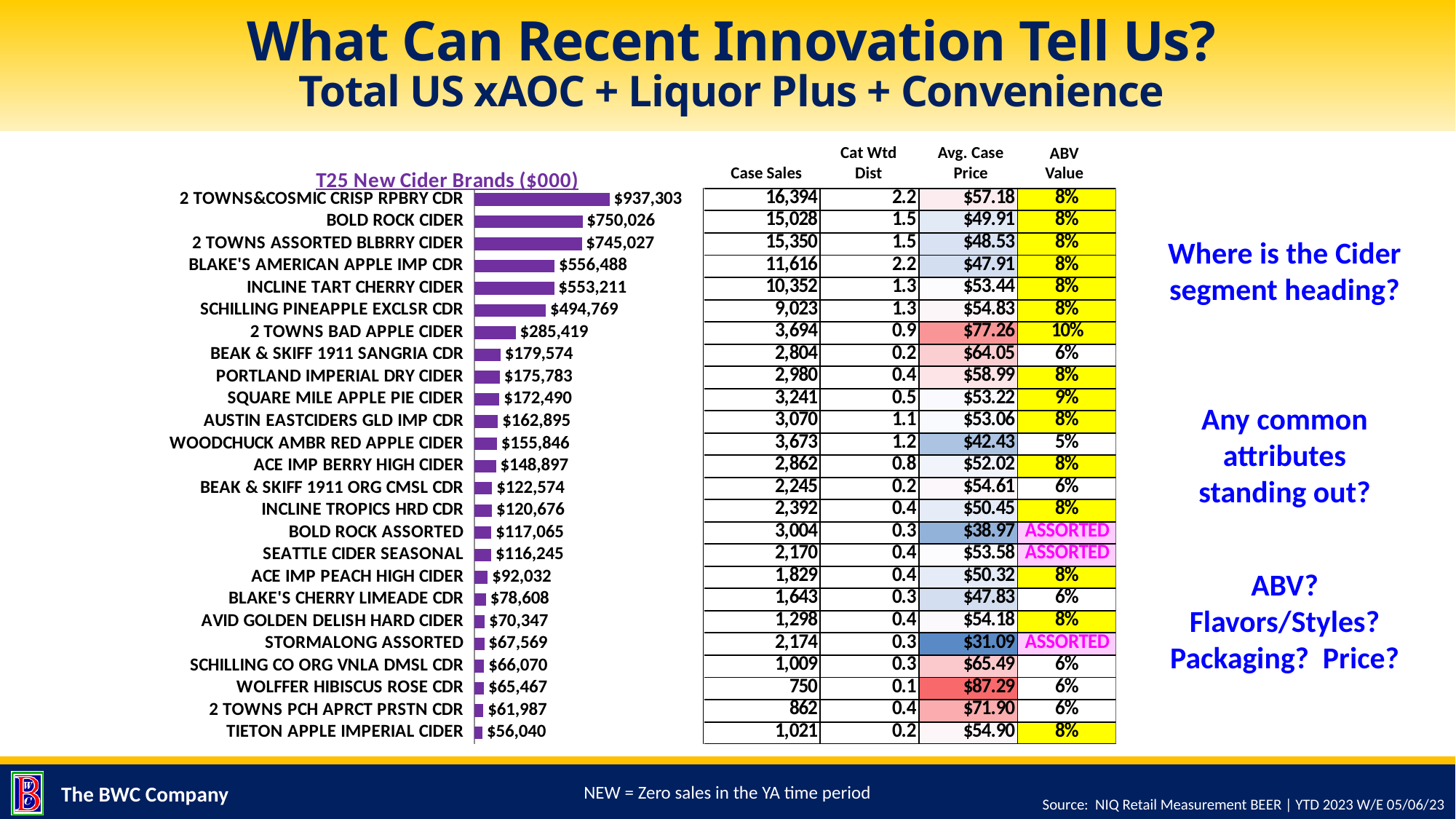
How many brands are shown in the T25 New Cider Brands chart? 25 What is the value for 2 TOWNS&COSMIC CRISP RPBRY CDR in the T25 New Cider Brands chart? $937,303 What is the value for WOODCHUCK AMBR RED APPLE CIDER in the T25 New Cider Brands chart? $155,846 What is the title of the bar chart on the slide? T25 New Cider Brands ($000) In the T25 New Cider Brands chart, which is larger: BLAKE'S AMERICAN APPLE IMP CDR or 2 TOWNS BAD APPLE CIDER? BLAKE'S AMERICAN APPLE IMP CDR In the T25 New Cider Brands chart, what is the difference between 2 TOWNS&COSMIC CRISP RPBRY CDR and BOLD ROCK CIDER? $187,277 What is the value for SCHILLING PINEAPPLE EXCLSR CDR in the T25 New Cider Brands chart? $494,769 Which brand has the lowest value in the T25 New Cider Brands chart? TIETON APPLE IMPERIAL CIDER Which brand has the highest value in the T25 New Cider Brands chart? 2 TOWNS&COSMIC CRISP RPBRY CDR What kind of chart is the T25 New Cider Brands chart? Bar chart What is the value for TIETON APPLE IMPERIAL CIDER in the T25 New Cider Brands chart? $56,040 In the T25 New Cider Brands chart, what is the difference between 2 TOWNS BAD APPLE CIDER and BEAK & SKIFF 1911 SANGRIA CDR? $105,845